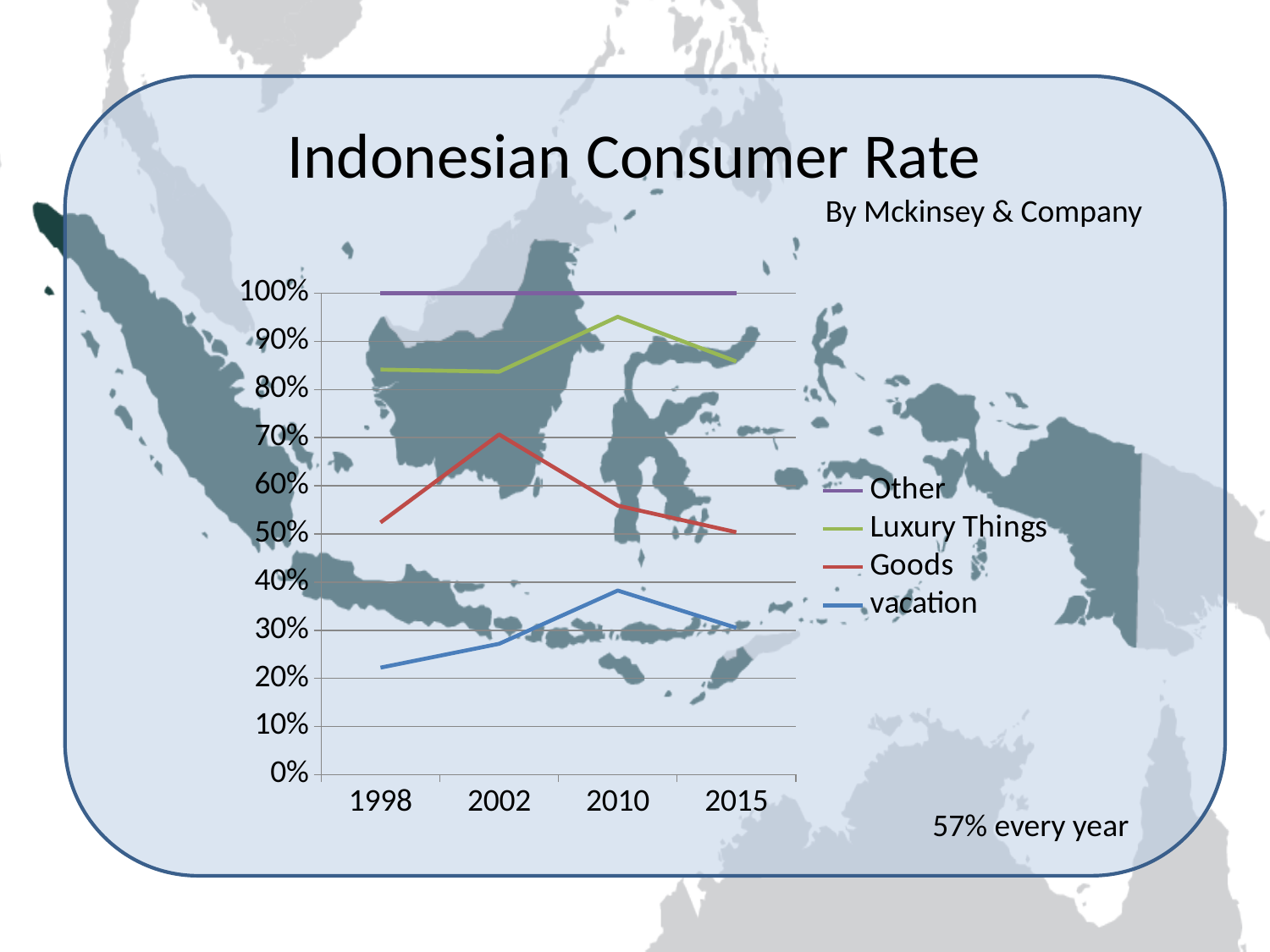
How many series does the legend list? 4 Does the Goods series rise or fall from 2002 to 2015? fall Is the value for Goods in 2002 greater or less than 60%? greater What kind of chart is shown on the slide? line chart What is the value for Other in 2010? 100% In which year does the Goods series reach its highest value? 2002 Is the value for vacation in 1998 greater or less than 30%? less Is the value for Luxury Things in 2010 greater or less than 90%? greater How many years are shown on the x axis? 4 In which year does the vacation series have its lowest value? 1998 Which series is higher in 2015, Goods or vacation? Goods What is the title of the chart? Indonesian Consumer Rate